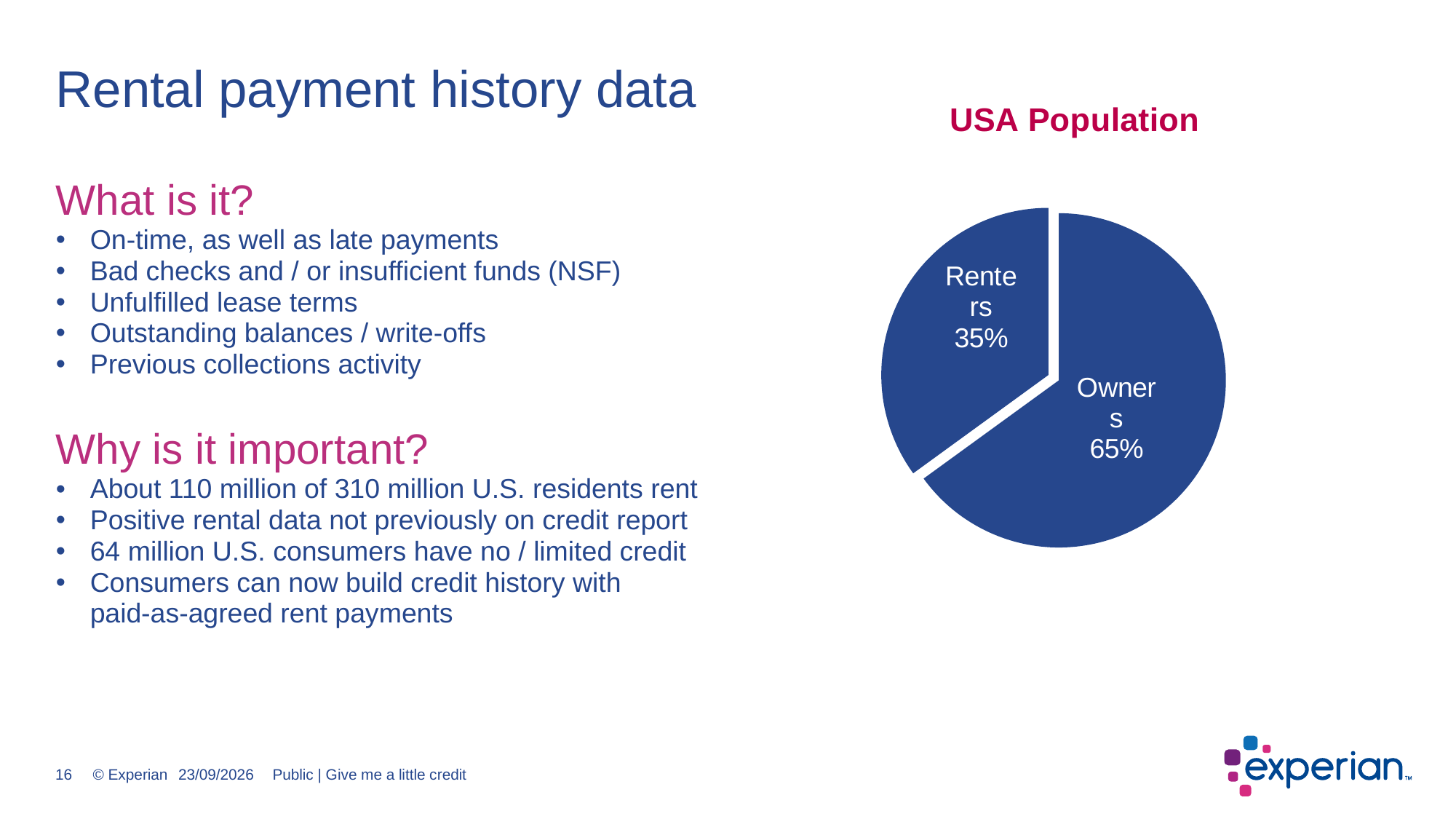
What share of the USA Population pie chart is Renters? 35% What share of the USA Population pie chart is Owners? 65% What is the difference in percentage points between Owners and Renters in the USA Population pie chart? 30 Which slice of the USA Population pie chart is the largest? Owners What kind of chart is shown on the slide? Pie chart Which slice of the USA Population pie chart is the smallest? Renters How many slices does the USA Population pie chart have? 2 What is the title of the chart on the slide? USA Population Is the Renters share in the USA Population pie chart greater or less than 50%? less In the USA Population pie chart, which is larger: Renters or Owners? Owners Is the Owners share in the USA Population pie chart greater or less than 50%? greater What do the two slices of the USA Population pie chart add up to? 100%